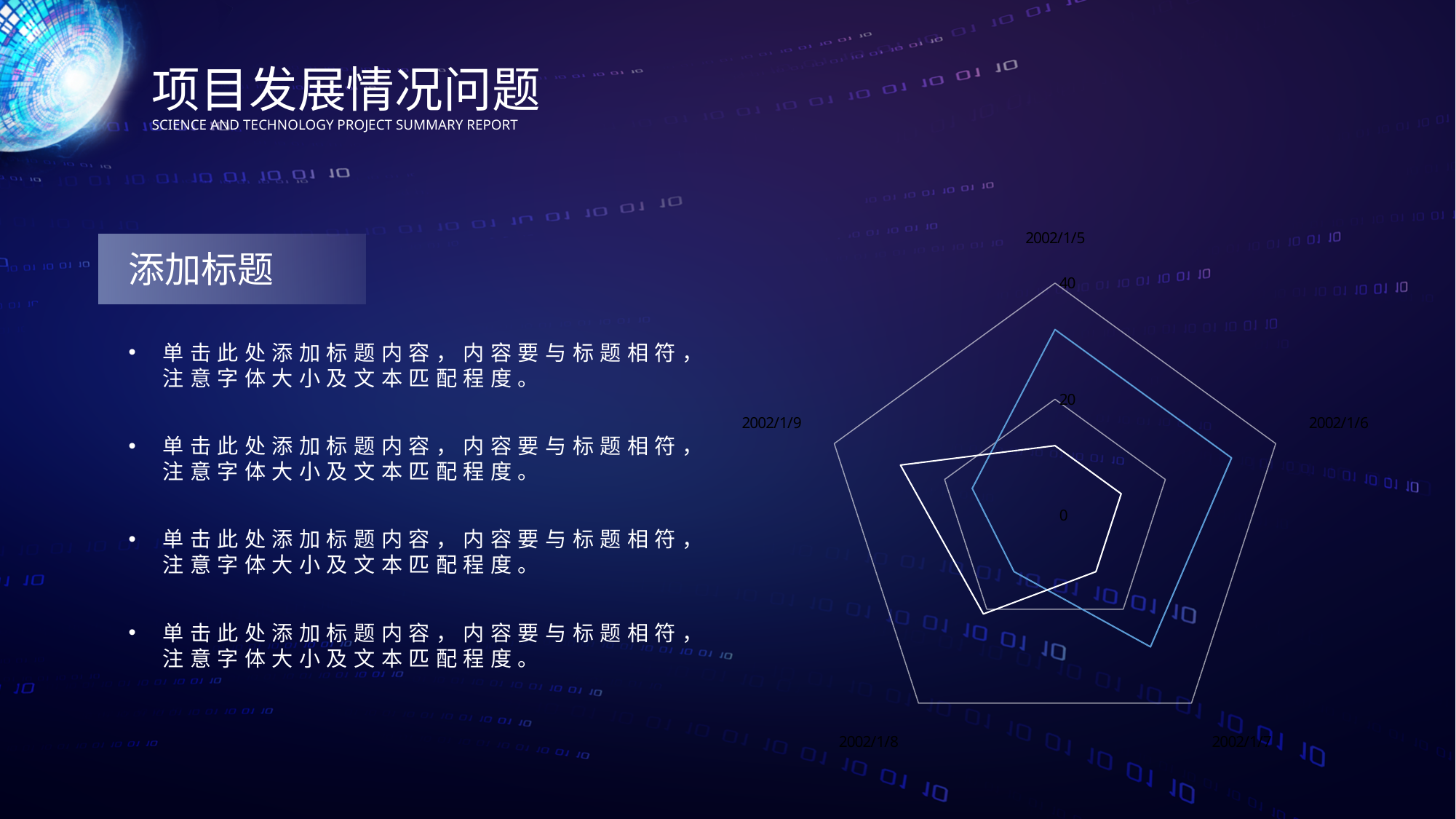
What kind of chart is shown on the slide? radar chart How many data series are plotted on the radar chart? 2 How many categories (axes) does the radar chart have? 5 Is the value of the light blue series for 2002/1/6 greater or less than 20? greater Is the value of the light blue series for 2002/1/8 greater or less than 20? less For 2002/1/5, which series has the larger value, the light blue series or the white series? the light blue series For 2002/1/9, which series has the larger value, the light blue series or the white series? the white series Is the value of the light blue series for 2002/1/5 greater or less than 20? greater What is the highest value shown on the radar chart's axis scale? 40 For which category does the white series reach its highest value? 2002/1/9